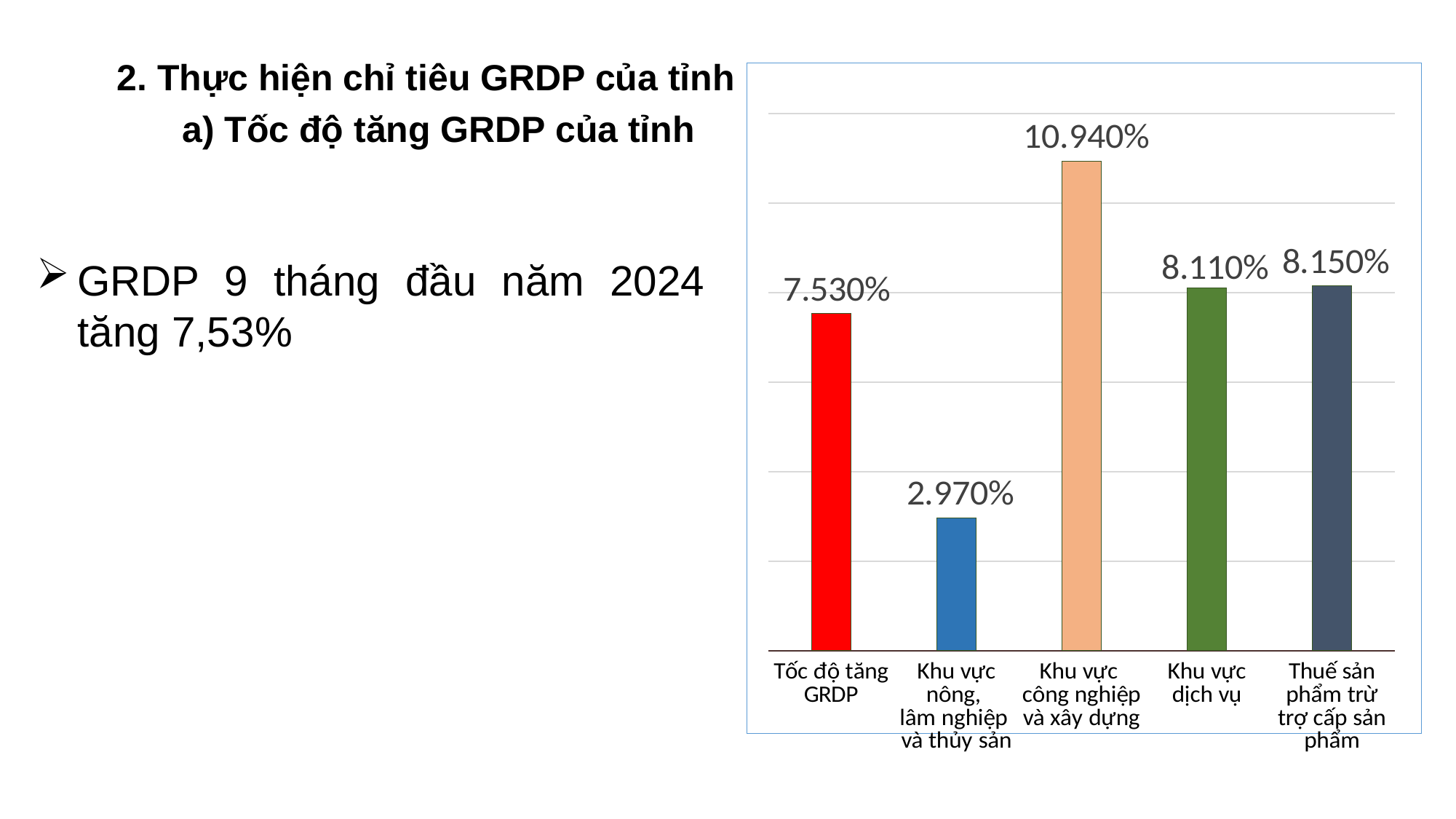
What kind of chart is shown on the slide? Bar chart What is the value for Khu vực nông, lâm nghiệp và thủy sản? 2.970% What is the difference between the values for Thuế sản phẩm trừ trợ cấp sản phẩm and Khu vực dịch vụ? 0.040% Which category has the lowest value? Khu vực nông, lâm nghiệp và thủy sản What is the value for Khu vực công nghiệp và xây dựng? 10.940% What is the value for Khu vực dịch vụ? 8.110% How many categories are shown in the chart? 5 What is the value for Tốc độ tăng GRDP? 7.530% Which is larger, the value for Tốc độ tăng GRDP or the value for Khu vực dịch vụ? Khu vực dịch vụ Which category has the highest value? Khu vực công nghiệp và xây dựng What is the difference between the values for Khu vực công nghiệp và xây dựng and Khu vực nông, lâm nghiệp và thủy sản? 7.970% What is the value for Thuế sản phẩm trừ trợ cấp sản phẩm? 8.150%